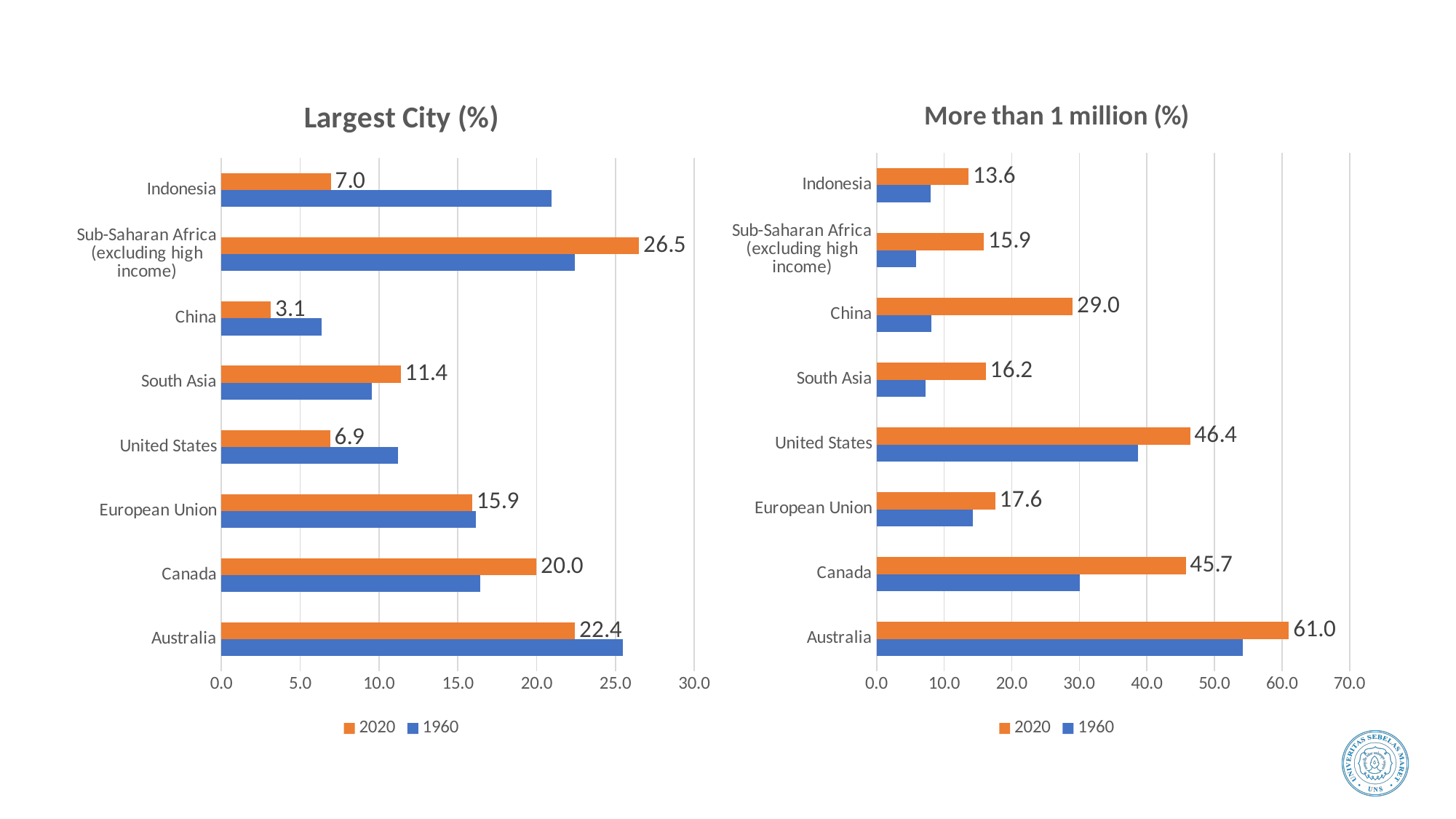
In the 'Largest City (%)' chart, what is the difference between the 2020 values for Canada and European Union? 4.1 In the 'More than 1 million (%)' chart, what is the difference between the 2020 values for Australia and United States? 14.6 How many series does the legend of the 'More than 1 million (%)' chart list? 2 What type of chart is the 'Largest City (%)' chart? Bar chart In the 'More than 1 million (%)' chart, which has the larger 2020 value, United States or Canada? United States In the 'More than 1 million (%)' chart, what is the 2020 value for China? 29.0 In the 'Largest City (%)' chart, what is the 2020 value for Sub-Saharan Africa (excluding high income)? 26.5 How many categories are shown in the 'Largest City (%)' chart? 8 In the 'Largest City (%)' chart, is the 1960 value for Indonesia greater or less than 20.0? greater In the 'More than 1 million (%)' chart, is the 1960 value for United States greater or less than 40.0? less In the 'Largest City (%)' chart, which category has the lowest 2020 value? China In the 'More than 1 million (%)' chart, which category has the highest 2020 value? Australia